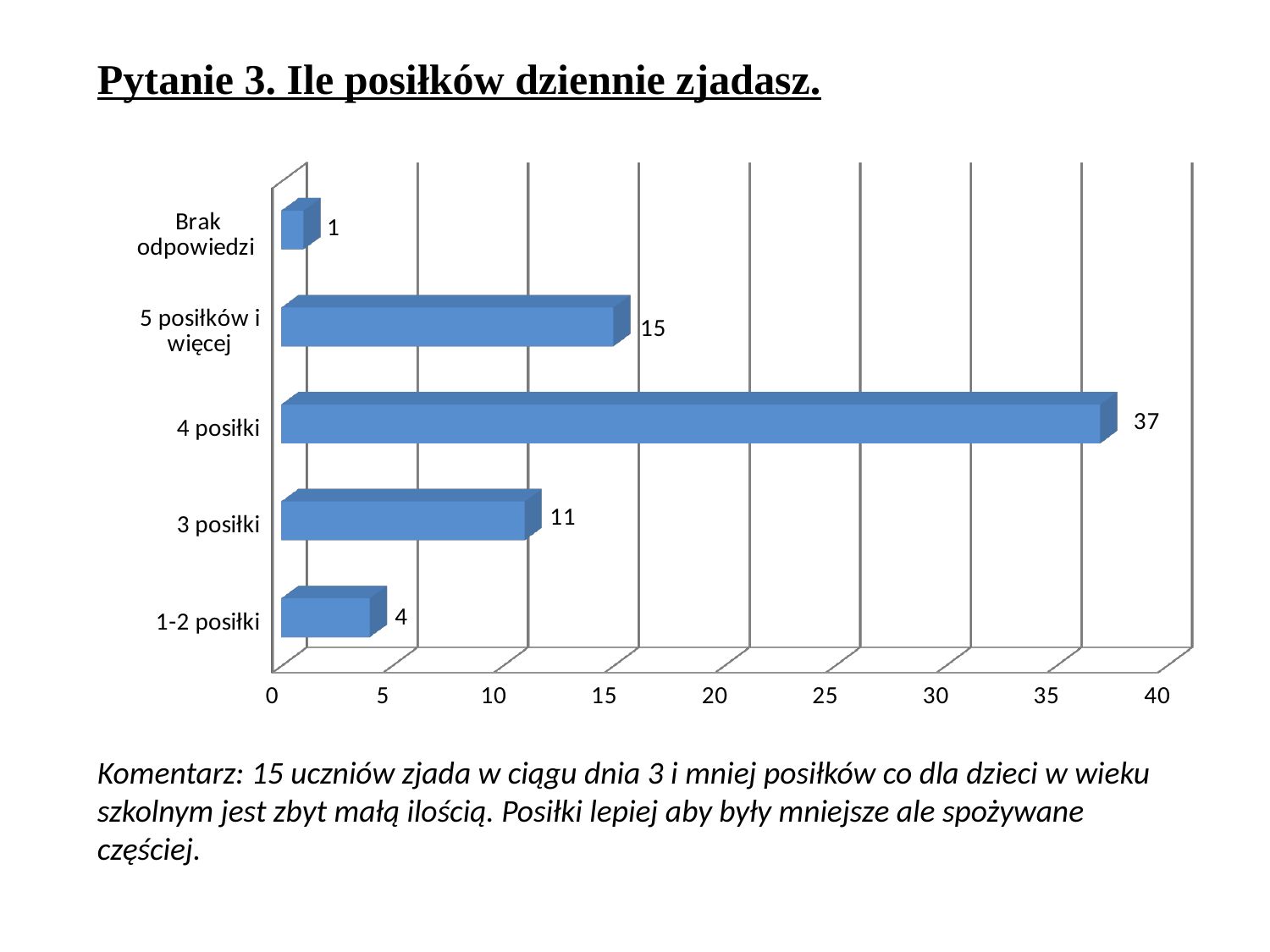
What kind of chart is shown on the slide? bar chart Which category has the lowest value? Brak odpowiedzi What is the difference between the values for "4 posiłki" and "3 posiłki"? 26 Which is larger, the value for "5 posiłków i więcej" or the value for "3 posiłki"? 5 posiłków i więcej How many categories are shown in the chart? 5 What is the value for "5 posiłków i więcej"? 15 What is the title of the slide above the chart? Pytanie 3. Ile posiłków dziennie zjadasz. What is the value for "1-2 posiłki"? 4 Which category has the highest value? 4 posiłki Is the value for "4 posiłki" greater or less than 35? greater What is the value for "4 posiłki"? 37 What is the value for "Brak odpowiedzi"? 1